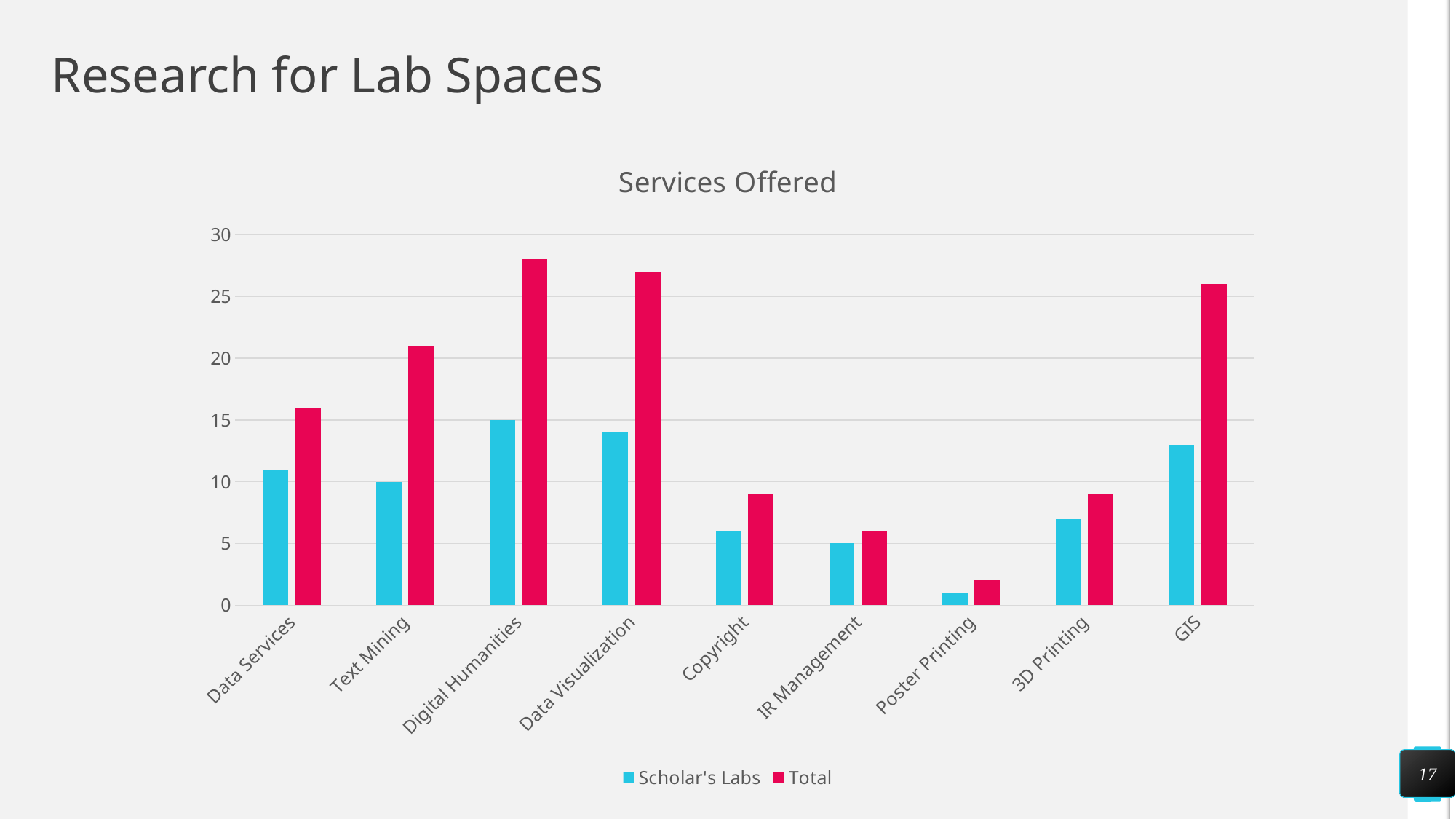
What is the Scholar's Labs value for Text Mining? 10 What type of chart is shown on the slide? Bar chart Is the Total value for Digital Humanities greater or less than 25? greater Which is larger, the Total value for GIS or the Total value for Text Mining? GIS How many service categories are shown on the x axis? 9 How many series does the legend list? 2 Which category has the lowest Total value? Poster Printing What is the Scholar's Labs value for IR Management? 5 What is the Scholar's Labs value for Digital Humanities? 15 Which series is shown in red? Total What is the title of the chart? Services Offered Is the Scholar's Labs value for Copyright greater or less than 10? less